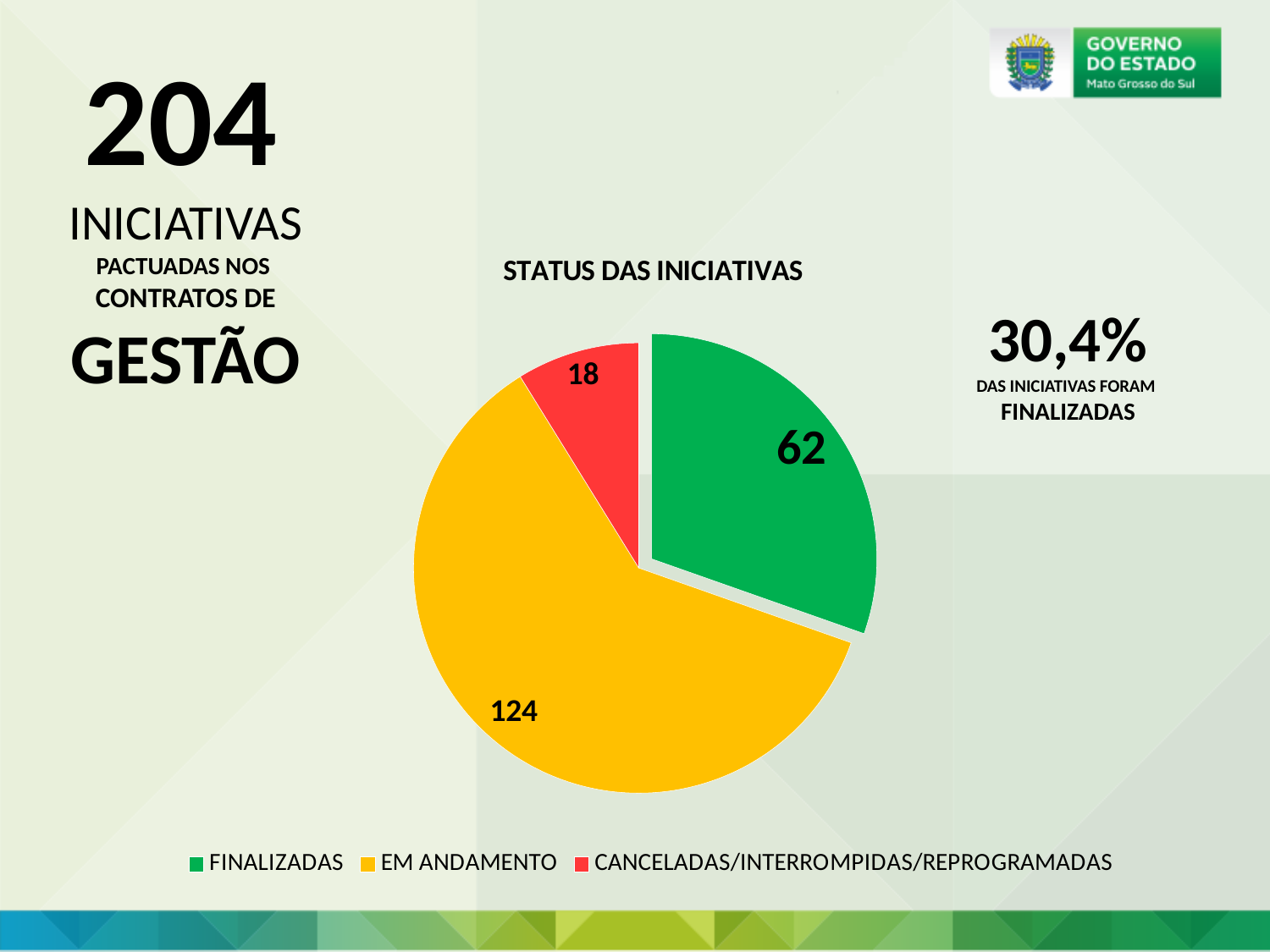
What type of chart is shown under the title STATUS DAS INICIATIVAS? pie chart How many categories does the STATUS DAS INICIATIVAS pie chart have? 3 What colour is the EM ANDAMENTO slice in the pie chart? yellow What is the difference between the FINALIZADAS and CANCELADAS/INTERROMPIDAS/REPROGRAMADAS values? 44 Which is larger in the pie chart, FINALIZADAS or CANCELADAS/INTERROMPIDAS/REPROGRAMADAS? FINALIZADAS What is the value for FINALIZADAS in the STATUS DAS INICIATIVAS pie chart? 62 Which category has the smallest slice in the STATUS DAS INICIATIVAS pie chart? CANCELADAS/INTERROMPIDAS/REPROGRAMADAS Which category has the largest slice in the STATUS DAS INICIATIVAS pie chart? EM ANDAMENTO What is the value for EM ANDAMENTO in the STATUS DAS INICIATIVAS pie chart? 124 What is the difference between the EM ANDAMENTO and FINALIZADAS values in the pie chart? 62 What share of the initiatives in the pie chart are FINALIZADAS? 30,4% What is the value for CANCELADAS/INTERROMPIDAS/REPROGRAMADAS in the pie chart? 18